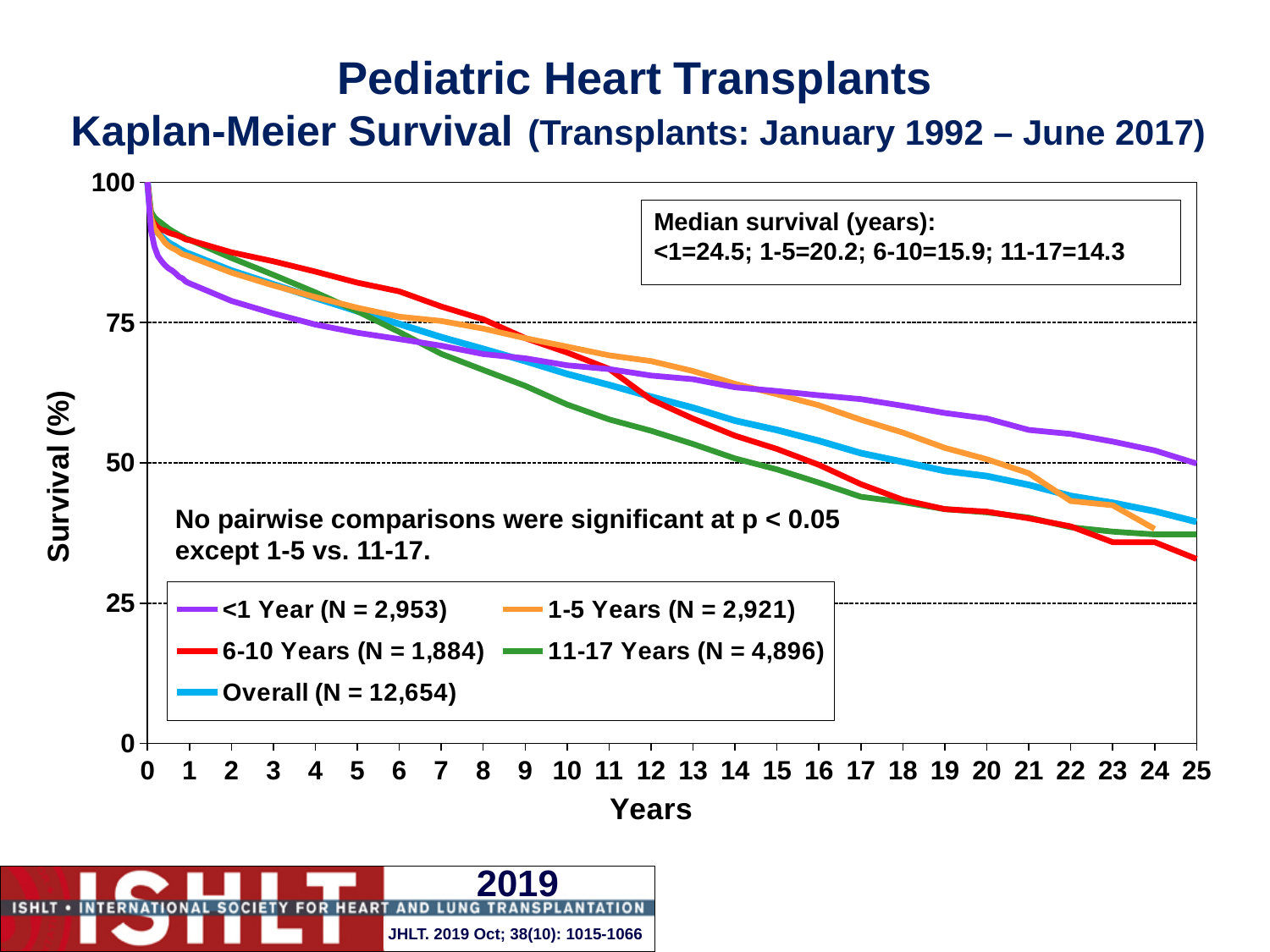
What kind of chart is shown on the slide? line chart Which has the larger median survival, the 1-5 years group or the 6-10 years group? 1-5 Years Which age group has the highest median survival? <1 Year What is the N for the Overall series in the legend? 12,654 What is the difference in median survival (years) between the <1 year group and the 11-17 years group? 10.2 Do the survival curves rise or fall as years since transplant increase? fall Is the survival value for the <1 Year group at 1 year greater or less than 75? greater Which age group has the lowest median survival? 11-17 Years What is the median survival in years for the <1 year age group? 24.5 What is the median survival in years for the 11-17 years age group? 14.3 How many series does the legend list? 5 Is the survival value for the 6-10 Years group at 25 years greater or less than 50? less